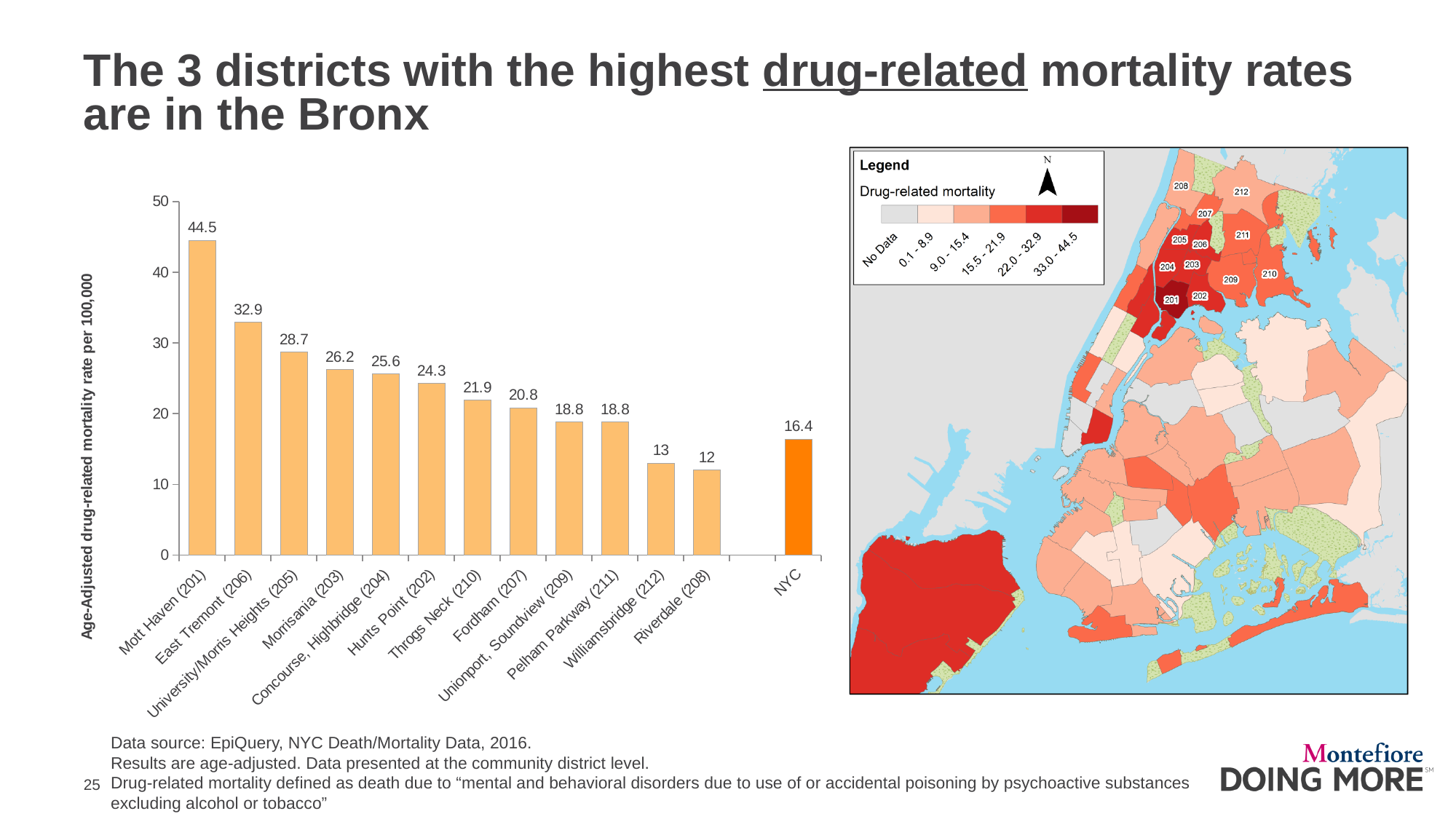
What kind of chart is used to show the drug-related mortality rates by district? Bar chart How many bars are plotted in the bar chart, including NYC? 13 What is the label of the y axis of the bar chart? Age-Adjusted drug-related mortality rate per 100,000 What is the difference between the drug-related mortality rates of Mott Haven (201) and East Tremont (206)? 11.6 Which district has the highest drug-related mortality rate in the bar chart? Mott Haven (201) What is the drug-related mortality rate shown for NYC? 16.4 What is the drug-related mortality rate for Hunts Point (202)? 24.3 Do the district bars rise or fall from left to right across the x axis (excluding the NYC bar)? Fall What is the age-adjusted drug-related mortality rate per 100,000 for Mott Haven (201)? 44.5 Is the drug-related mortality rate for Morrisania (203) greater or less than 30? less Which has a higher drug-related mortality rate, Fordham (207) or Williamsbridge (212)? Fordham (207) Which district has the lowest drug-related mortality rate in the bar chart? Riverdale (208)